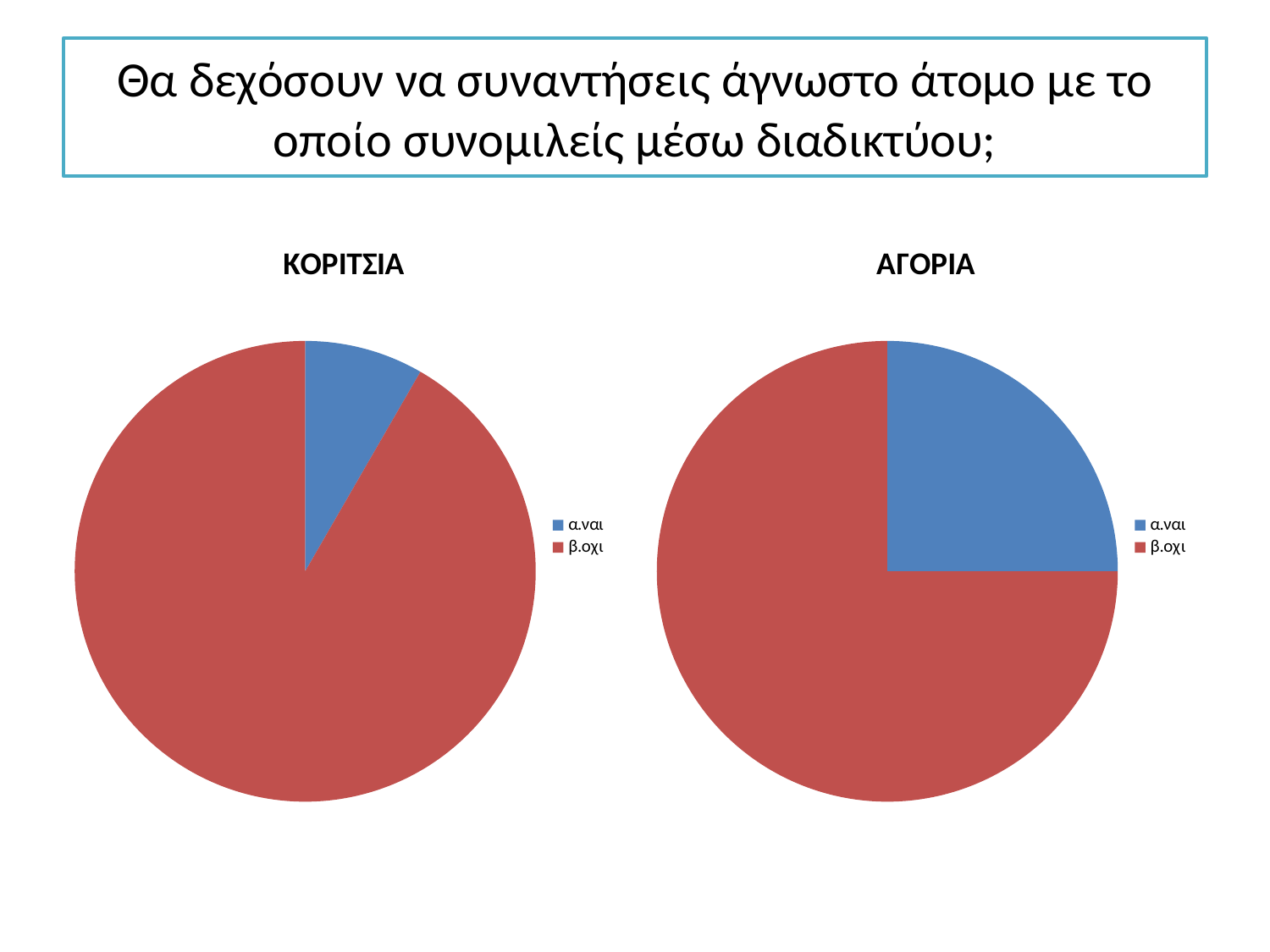
Is the α.ναι slice larger in the ΚΟΡΙΤΣΙΑ chart or in the ΑΓΟΡΙΑ chart? ΑΓΟΡΙΑ What kind of chart is the ΑΓΟΡΙΑ chart? pie chart In the ΑΓΟΡΙΑ chart, which category has the largest slice? β.οχι How many slices does the ΑΓΟΡΙΑ pie chart have? 2 How many entries does the legend of the ΑΓΟΡΙΑ chart list? 2 How many slices does the ΚΟΡΙΤΣΙΑ pie chart have? 2 In the ΚΟΡΙΤΣΙΑ chart, which category has the smallest slice? α.ναι In the ΚΟΡΙΤΣΙΑ chart, which category has the largest slice? β.οχι What colour is the β.οχι slice in the ΑΓΟΡΙΑ chart? red In the ΑΓΟΡΙΑ chart, which category has the smallest slice? α.ναι In the ΚΟΡΙΤΣΙΑ chart, is the α.ναι slice larger or smaller than the β.οχι slice? smaller What kind of chart is the ΚΟΡΙΤΣΙΑ chart? pie chart